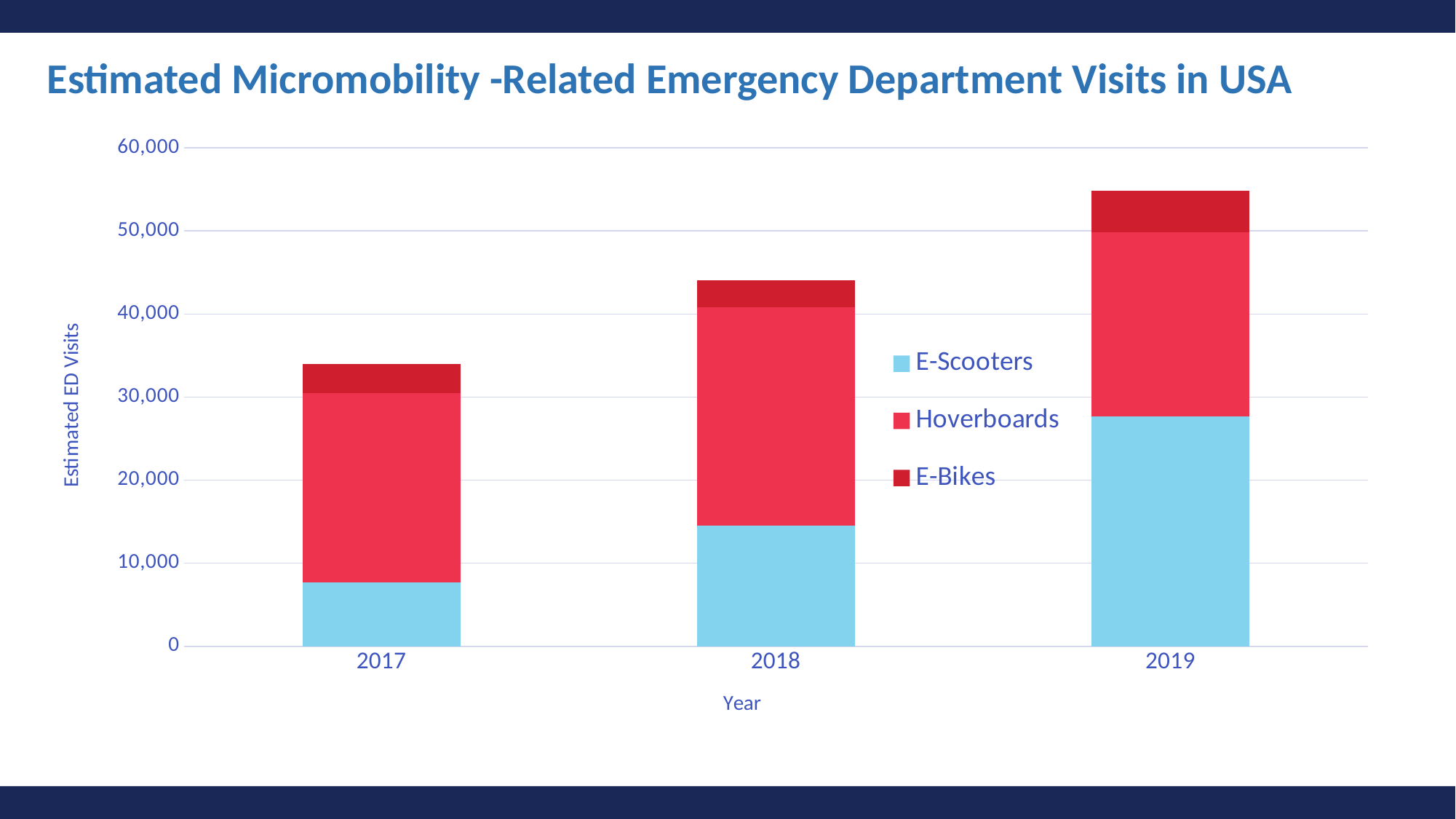
Which year has the lowest total estimated ED visits? 2017 Is the E-Scooters value for 2017 greater or less than 10,000? less What kind of chart is shown on the slide? bar chart Is the E-Scooters value for 2019 greater or less than 30,000? less How many series does the legend list? 3 Is the total value for 2017 greater or less than 30,000? greater Which is larger, the E-Scooters value for 2018 or the E-Scooters value for 2019? 2019 How many years are shown on the x axis? 3 What is the title of the y axis? Estimated ED Visits Do the total estimated ED visits rise or fall from 2017 to 2019? rise Which year has the highest total estimated ED visits? 2019